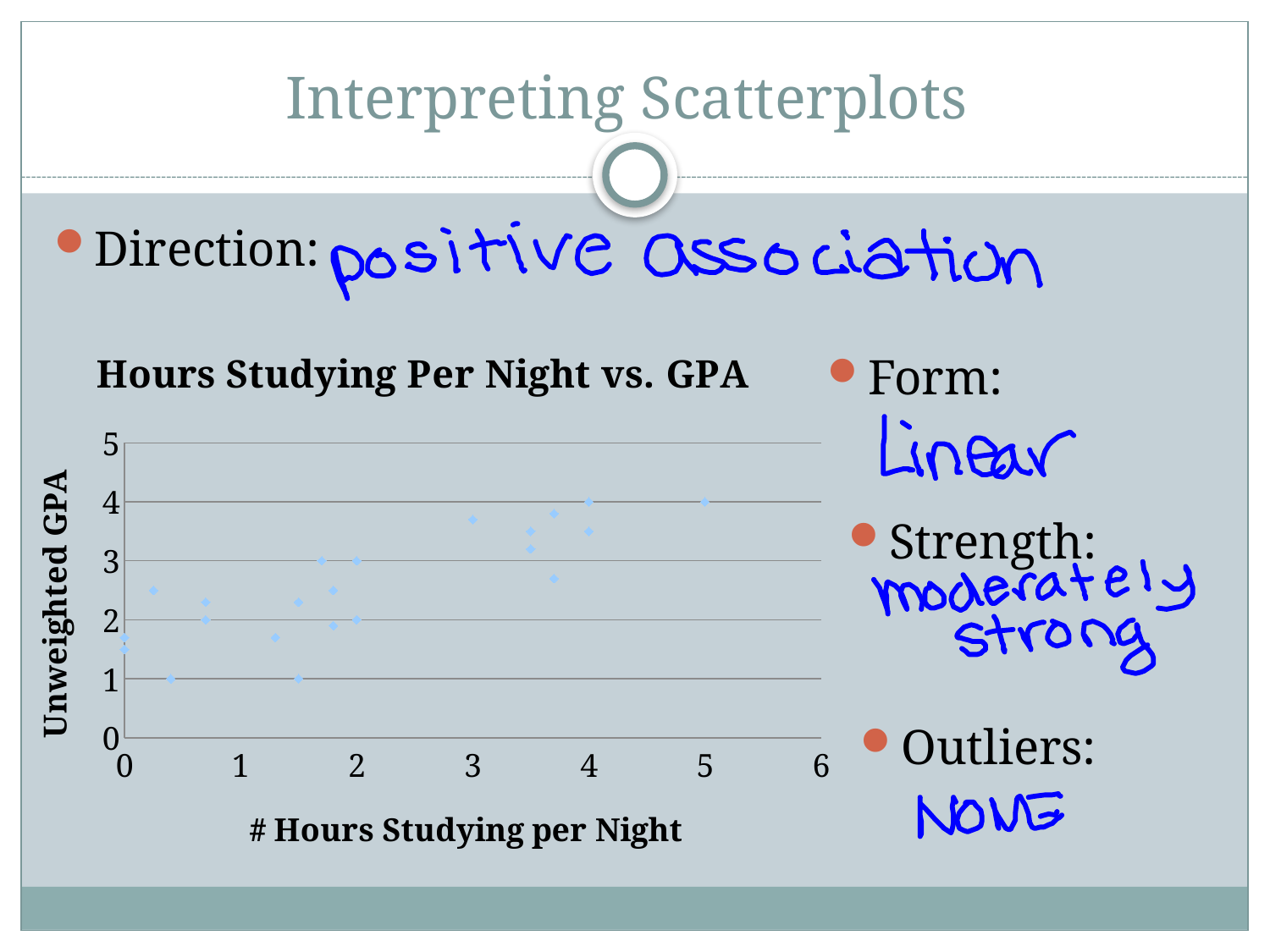
Is the GPA of the point at 3 hours studying per night greater or less than 3? greater What is the unweighted GPA of the point plotted at 5 hours studying per night? 4 What is the highest unweighted GPA value plotted on the chart? 4 What is the lowest unweighted GPA value plotted on the chart? 1 What is the title of the chart? Hours Studying Per Night vs. GPA What is the label of the vertical axis of the chart? Unweighted GPA Is the GPA of the point at 0.4 hours studying per night greater or less than 2? less What kind of chart is shown on the slide? scatter plot Is the GPA of the point at 5 hours greater or less than the GPA of the point at 0.4 hours? greater What is the largest number of hours studying per night among the plotted points? 5 What is the maximum value shown on the horizontal axis of the chart? 6 Do the GPA values generally rise or fall as the number of hours studying per night increases? rise